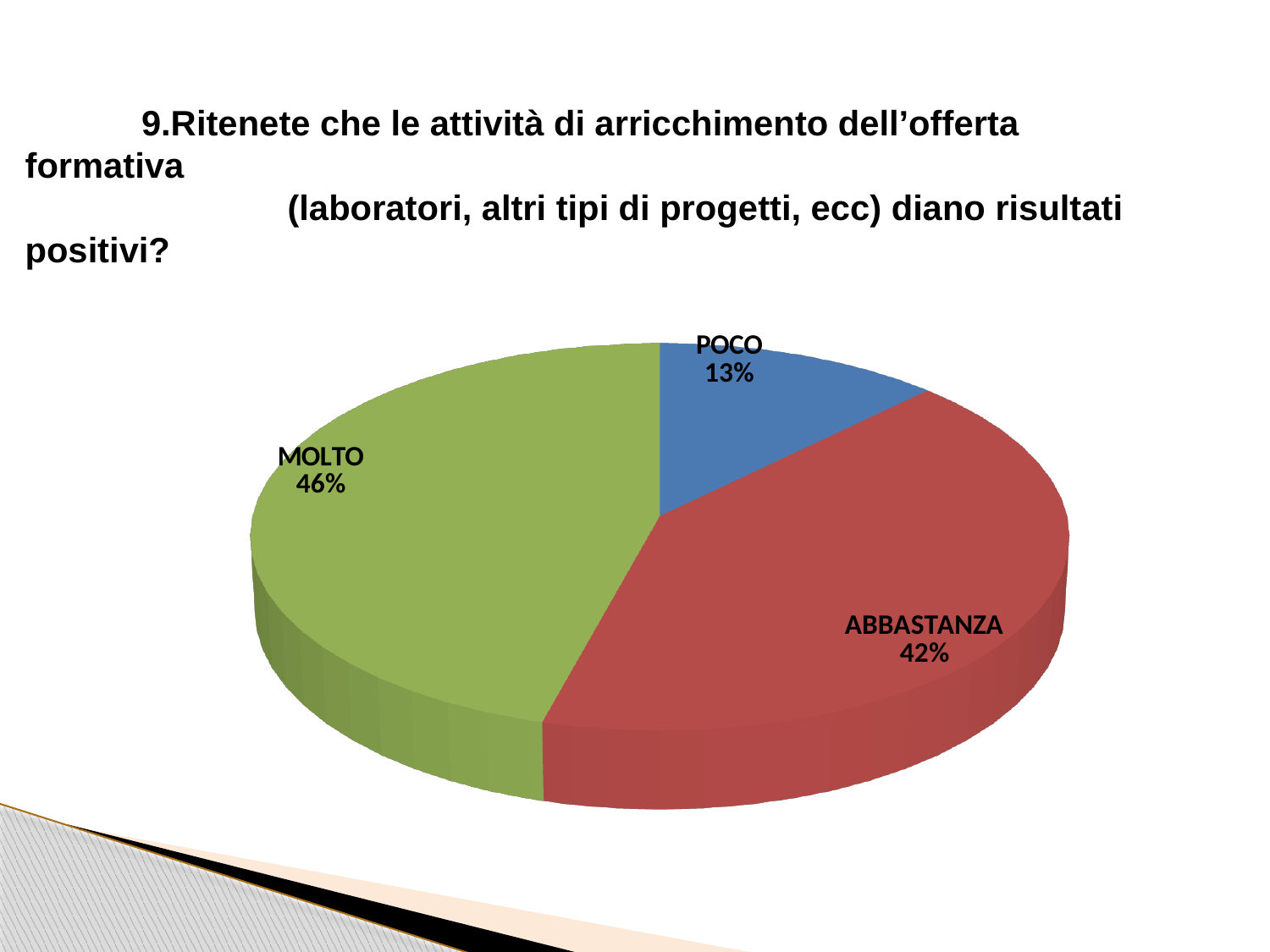
What colour is the slice labelled ABBASTANZA? Red What is the difference in percentage points between the MOLTO and ABBASTANZA slices? 4 How many slices does the pie chart have? 3 Which slice is larger, MOLTO or POCO? MOLTO What colour is the slice labelled POCO? Blue What percentage of the pie chart is labelled MOLTO? 46% Which category has the smallest share of the pie chart? POCO What is the difference in percentage points between the ABBASTANZA and POCO slices? 29 What percentage of the pie chart is labelled POCO? 13% What percentage of the pie chart is labelled ABBASTANZA? 42% Which category has the largest share of the pie chart? MOLTO What kind of chart is shown on the slide? Pie chart